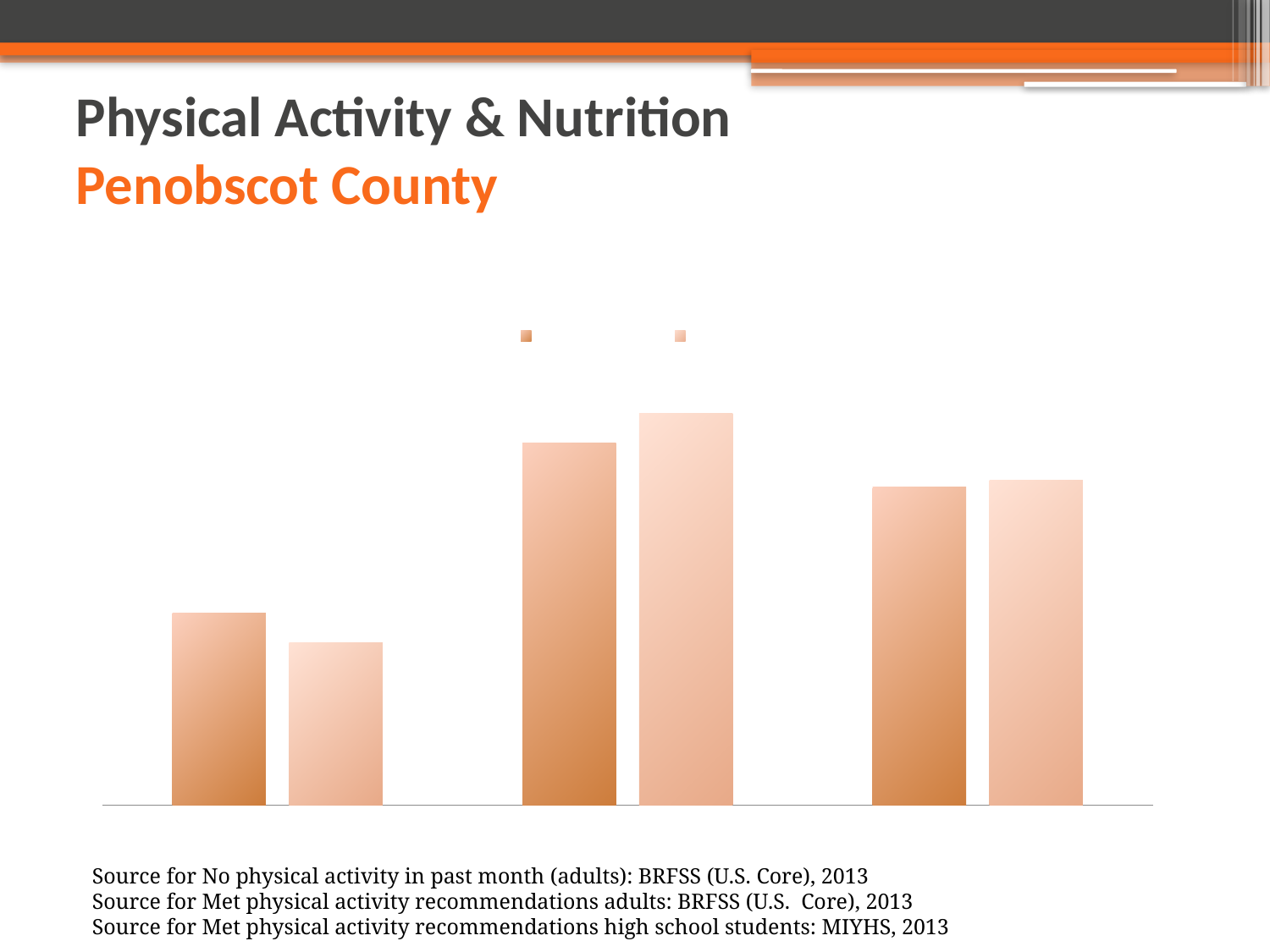
What colour are the bars in the chart? orange Which group of bars, counting from the left, has the shortest bars? the first (leftmost) group How many series does the chart's legend show? 2 How many groups of bars does the chart show? 3 What kind of chart is shown on the slide? bar chart Does the chart display any data labels or axis values? No Which group of bars, counting from the left, has the tallest bars? the middle (second) group In the middle group, is the darker orange bar or the lighter bar taller? the lighter bar In the leftmost group, is the darker orange bar or the lighter bar taller? the darker orange bar How many bars are plotted in total on the chart? 6